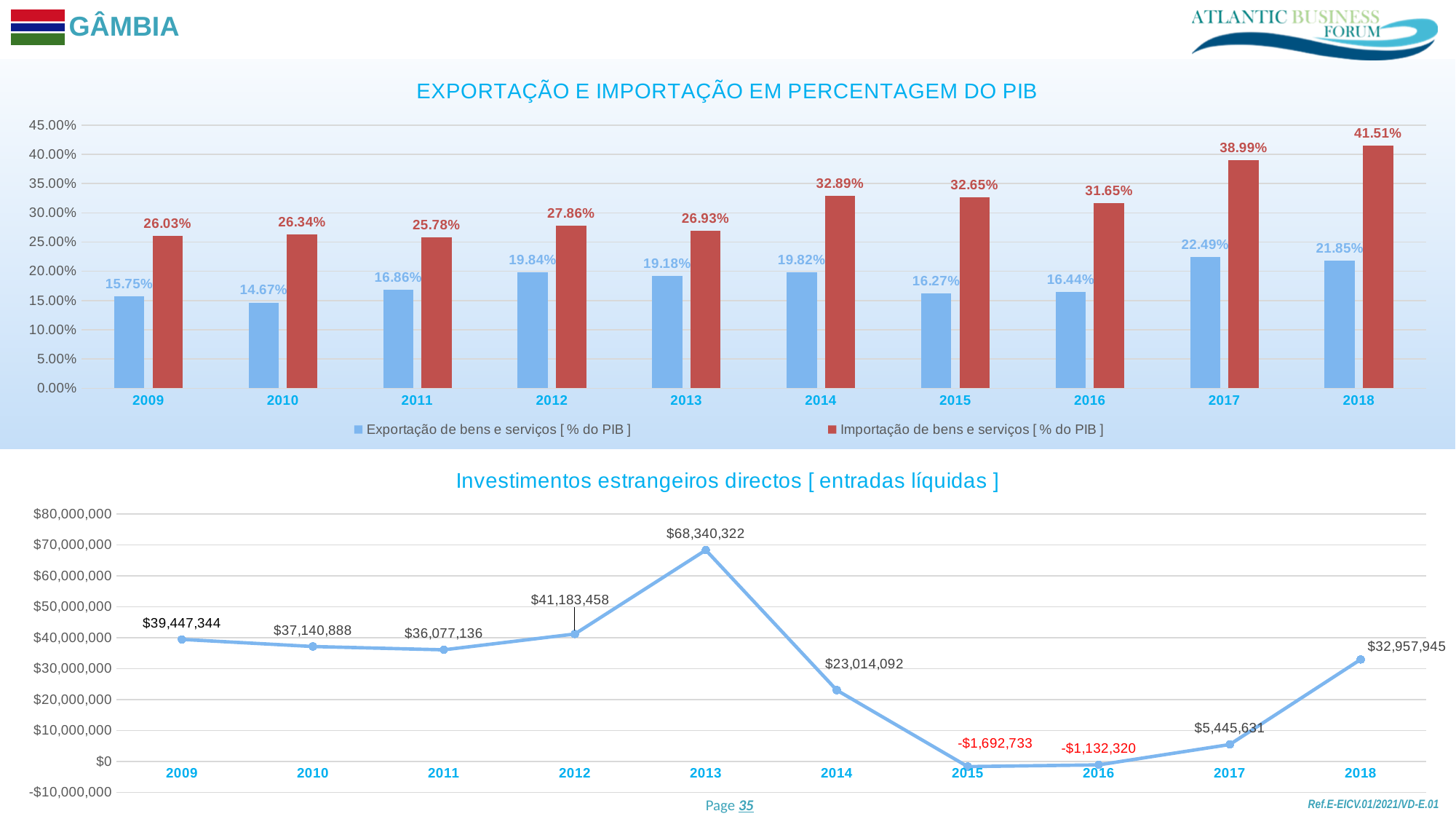
In the chart 'EXPORTAÇÃO E IMPORTAÇÃO EM PERCENTAGEM DO PIB', what kind of chart is it? Bar chart In the chart 'EXPORTAÇÃO E IMPORTAÇÃO EM PERCENTAGEM DO PIB', what is the value of Importação de bens e serviços for 2017? 38.99% In the chart 'EXPORTAÇÃO E IMPORTAÇÃO EM PERCENTAGEM DO PIB', which year has the lowest Exportação de bens e serviços value? 2010 In the chart 'Investimentos estrangeiros directos [ entradas líquidas ]', what is the value for 2013? $68,340,322 In the chart 'Investimentos estrangeiros directos [ entradas líquidas ]', which is larger, the value for 2009 or the value for 2018? 2009 In the chart 'Investimentos estrangeiros directos [ entradas líquidas ]', what kind of chart is it? Line chart In the chart 'EXPORTAÇÃO E IMPORTAÇÃO EM PERCENTAGEM DO PIB', which year has the highest Importação de bens e serviços value? 2018 In the chart 'Investimentos estrangeiros directos [ entradas líquidas ]', how many years are plotted? 10 In the chart 'EXPORTAÇÃO E IMPORTAÇÃO EM PERCENTAGEM DO PIB', what is the difference between Importação and Exportação in 2018? 19.66% In the chart 'Investimentos estrangeiros directos [ entradas líquidas ]', which year has the lowest value? 2015 In the chart 'EXPORTAÇÃO E IMPORTAÇÃO EM PERCENTAGEM DO PIB', what is the value of Exportação de bens e serviços for 2012? 19.84% In the chart 'EXPORTAÇÃO E IMPORTAÇÃO EM PERCENTAGEM DO PIB', how many series does the legend list? 2